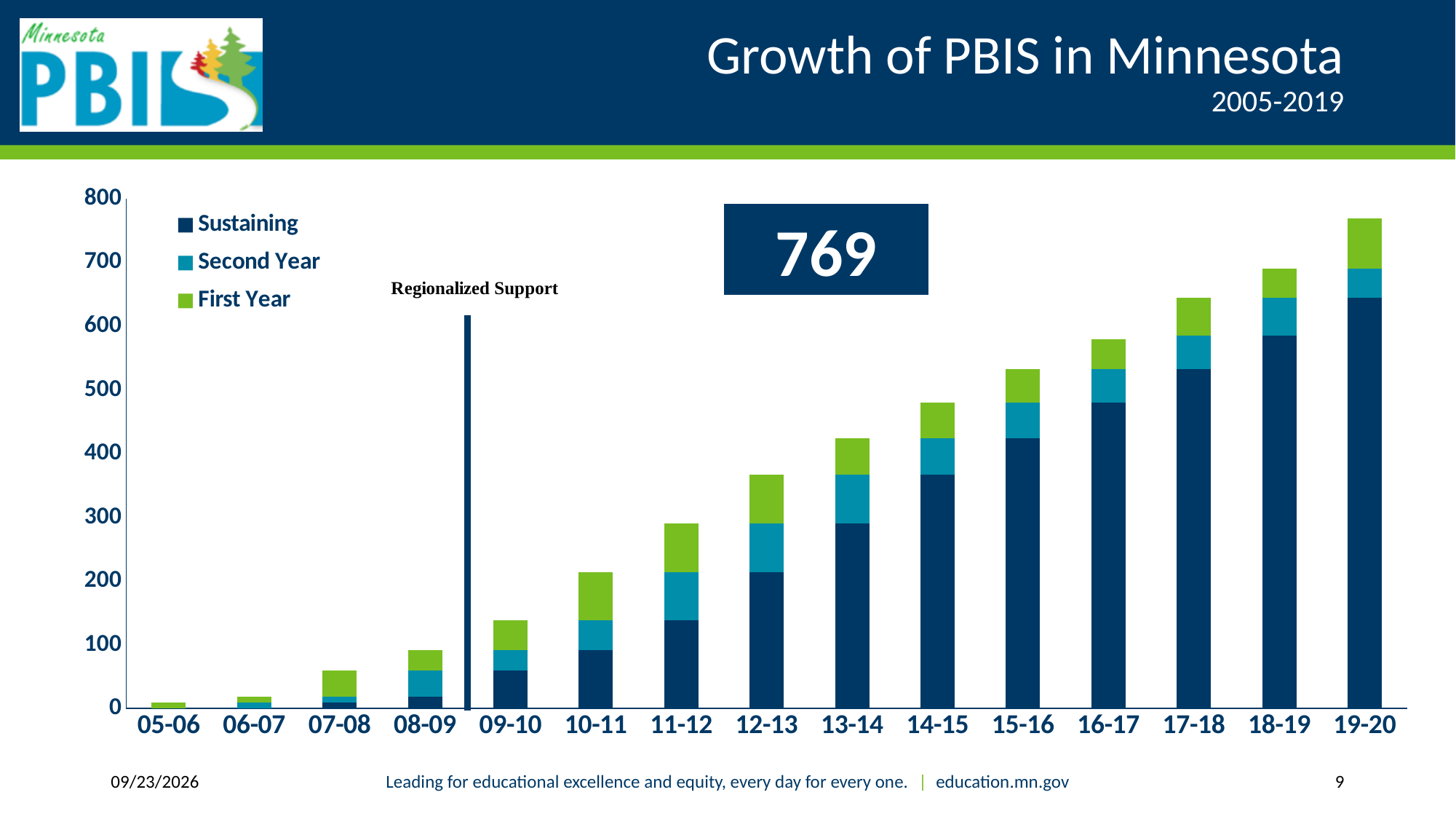
Is the total bar for 12-13 greater or less than 400? less Is the Sustaining segment for 19-20 greater or less than 600? greater Which total bar is taller, 14-15 or 13-14? 14-15 Is the total bar for 19-20 greater or less than 700? greater How many series does the legend list? 3 Which school year has the shortest total bar? 05-06 What kind of chart is shown on the slide? Stacked bar chart How many school-year categories are shown on the x axis? 15 Do the total bar heights generally rise or fall from 05-06 to 19-20? Rise What number is displayed in the highlighted box above the chart? 769 Which school year has the tallest total bar? 19-20